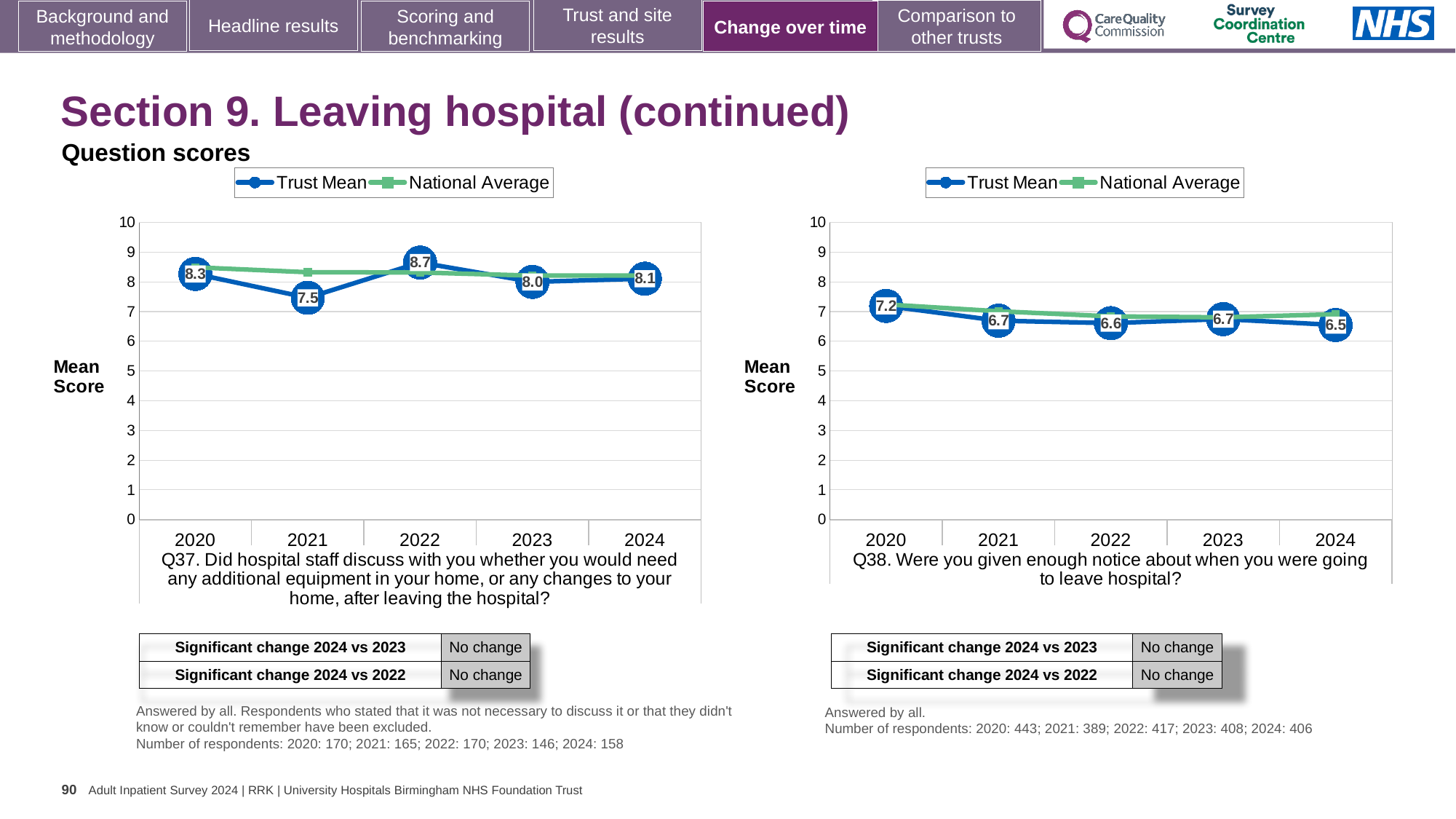
In the Q38 chart (right), what is the Trust Mean score for 2020? 7.2 In the Q37 chart (left), what is the Trust Mean score for 2021? 7.5 In the Q38 chart (right), which year has the highest Trust Mean score? 2020 In the Q37 chart (left), what is the difference between the Trust Mean scores for 2022 and 2021? 1.2 What kind of chart is the Q37 chart (left)? line chart How many years are plotted on the x axis of the Q38 chart (right)? 5 How many series does the legend of the Q37 chart (left) list? 2 In the Q38 chart (right), is the Trust Mean score for 2020 larger or smaller than the score for 2024? larger In the Q37 chart (left), which year has the lowest Trust Mean score? 2021 In the Q38 chart (right), what is the Trust Mean score for 2024? 6.5 In the Q37 chart (left), which year has the highest Trust Mean score? 2022 In the Q37 chart (left), what is the Trust Mean score for 2022? 8.7